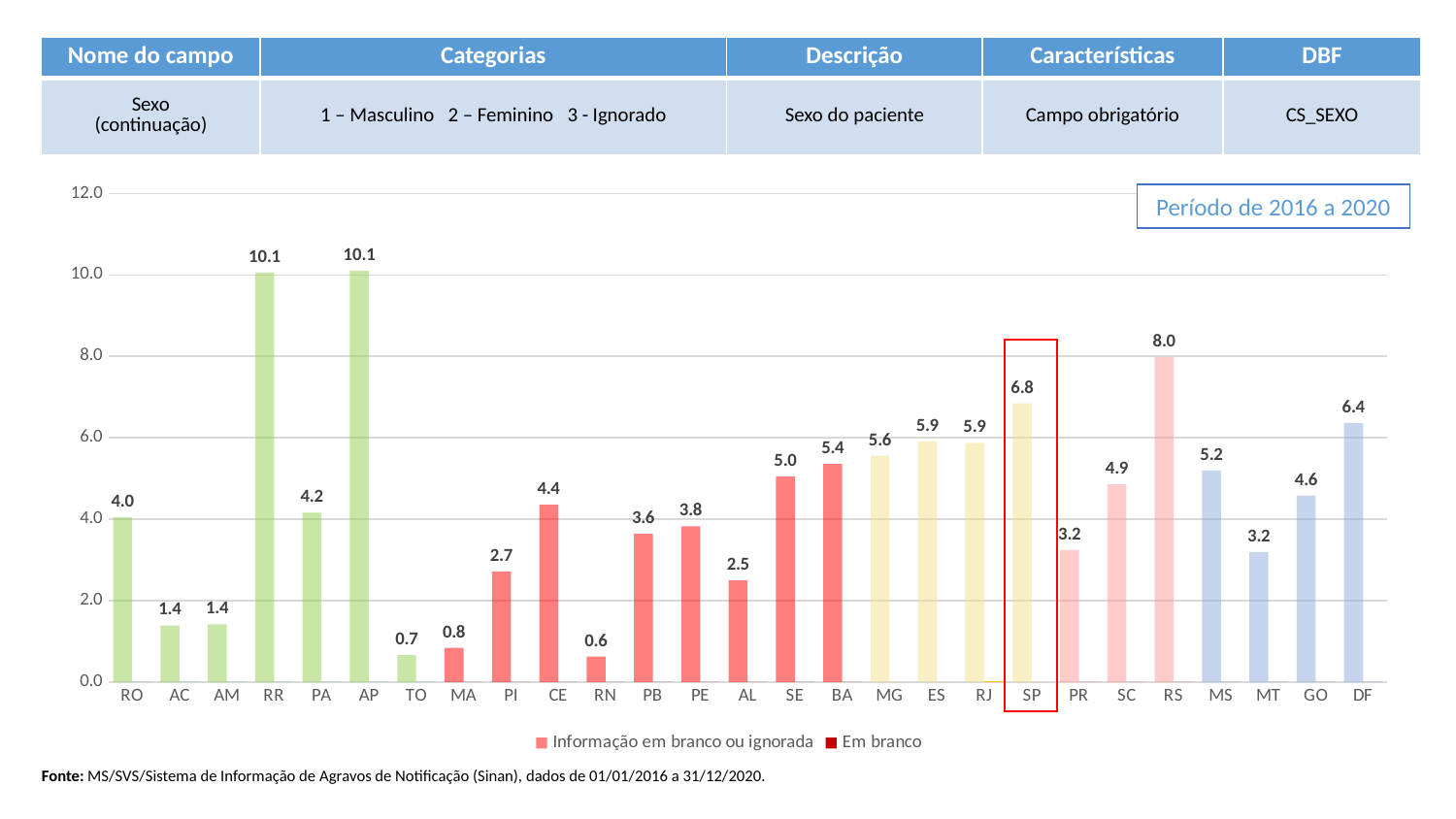
Which category has the lowest value? RN Which is larger, the value for DF or the value for MS? DF What is the value for RN? 0.6 How many categories are shown on the x axis? 27 What is the difference between the values for RS and SP? 1.2 How many series does the legend list? 2 What is the value for SP? 6.8 Which two categories share the highest value of 10.1? RR and AP What kind of chart is shown? bar chart What is the value for RS? 8.0 Is the value for BA greater or less than 4.0? greater What period does the label in the top right of the chart indicate? Período de 2016 a 2020